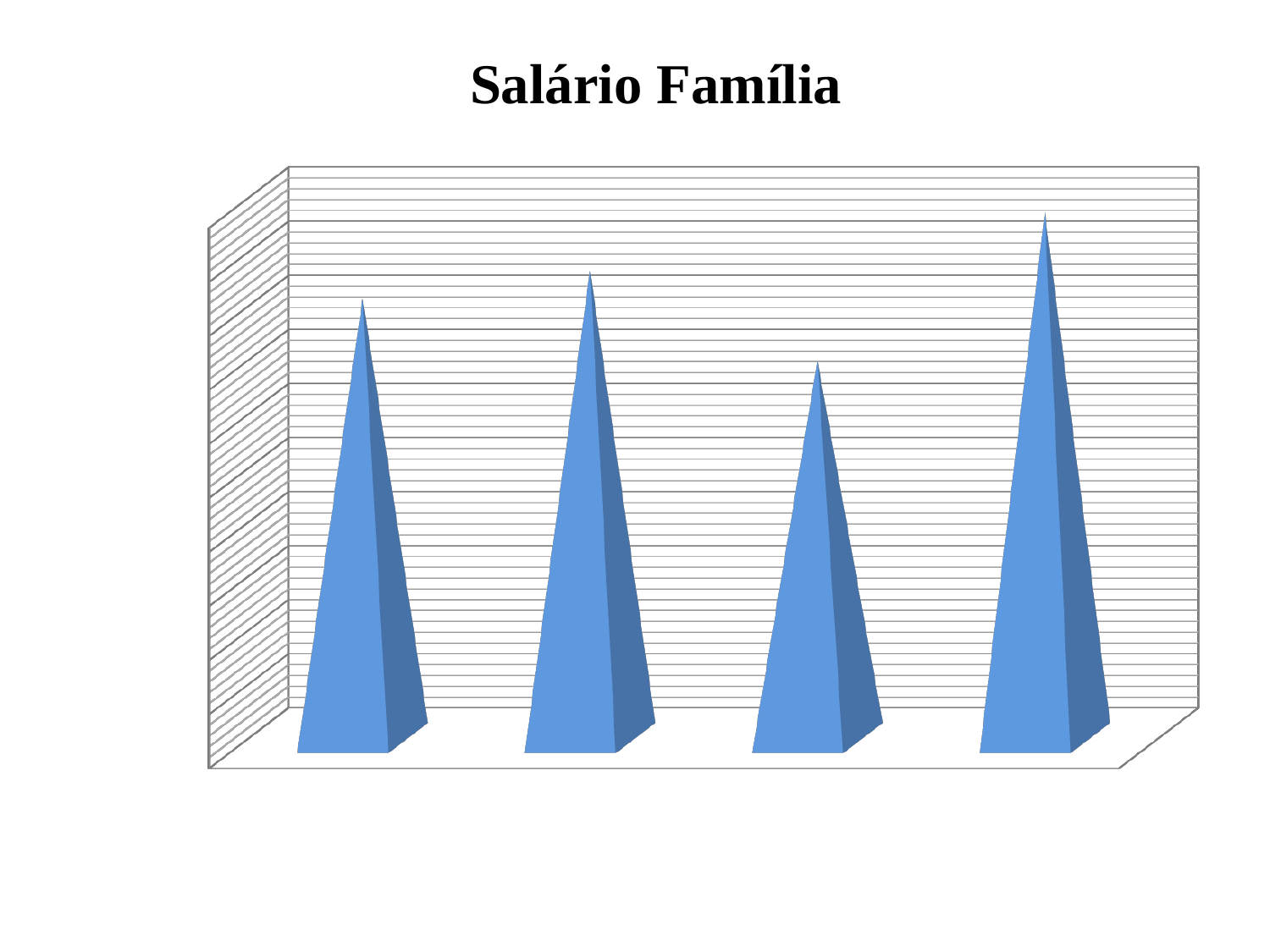
How many bars are plotted in the chart? 4 What is the title of the chart? Salário Família What kind of chart is shown on the slide? bar chart Which bar, counting from the left, is the tallest? the fourth bar Which is taller, the first bar from the left or the fourth bar? the fourth bar What colour are the bars in the chart? blue Which is taller, the second bar from the left or the third bar? the second bar Which bar, counting from the left, is the shortest? the third bar Which is taller, the first bar from the left or the second bar? the second bar